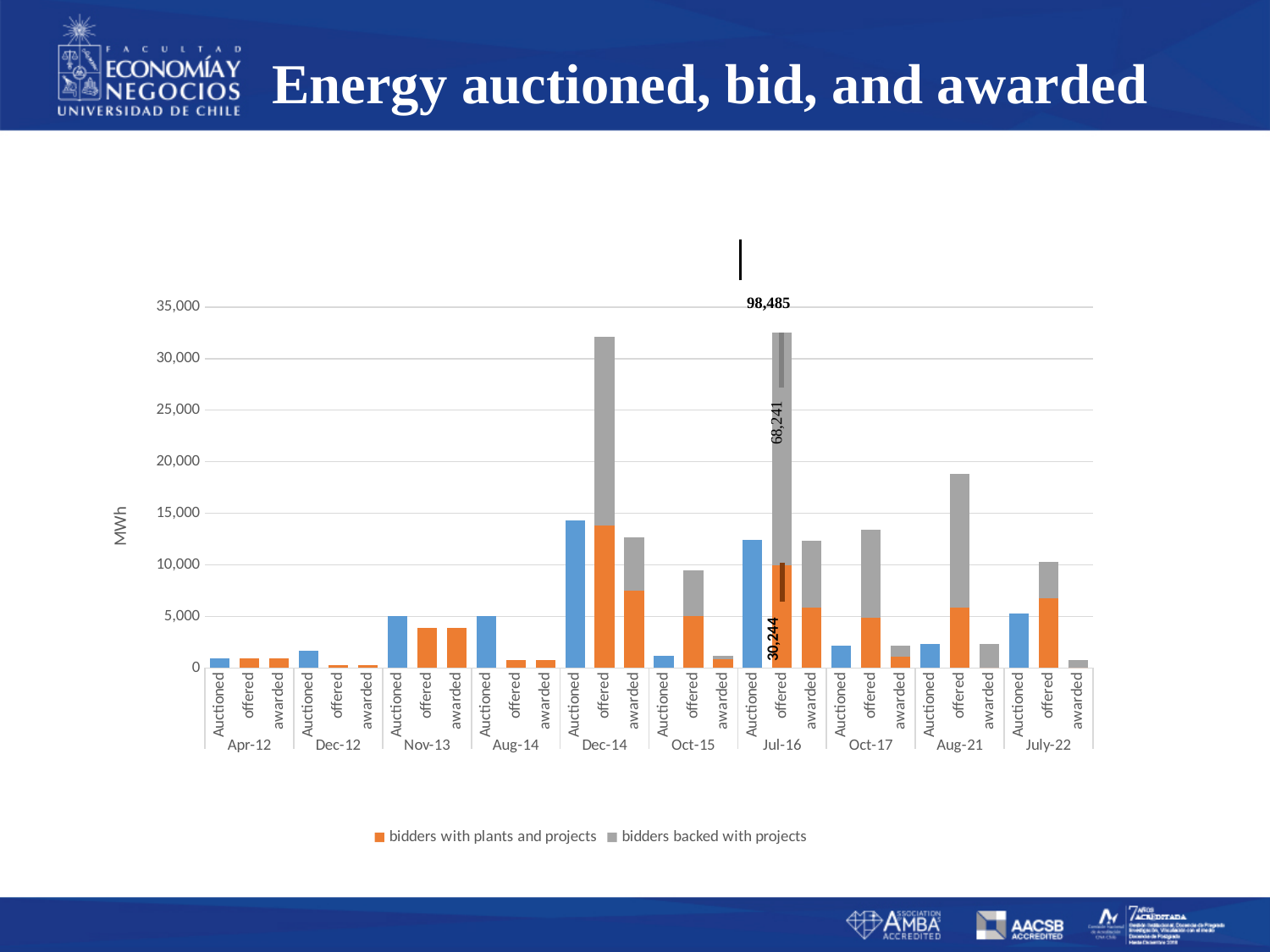
What is the total value of the 'offered' bar for Jul-16? 98,485 Is the 'Auctioned' value for Apr-12 greater or less than 5,000? less What is the label on the vertical axis? MWh What kind of chart is shown on the slide? bar chart What is the value of 'bidders with plants and projects' in the Jul-16 'offered' bar? 30,244 Is the 'Auctioned' value for Dec-14 greater or less than 10,000? greater Is the 'offered' value for Aug-21 greater or less than 15,000? greater How many series does the legend list? 2 Which auction date has the highest 'offered' bar? Jul-16 Which is larger, the 'offered' bar for Dec-14 or the 'offered' bar for Oct-15? Dec-14 How many auction dates are shown along the x axis? 10 What is the value of 'bidders backed with projects' in the Jul-16 'offered' bar? 68,241